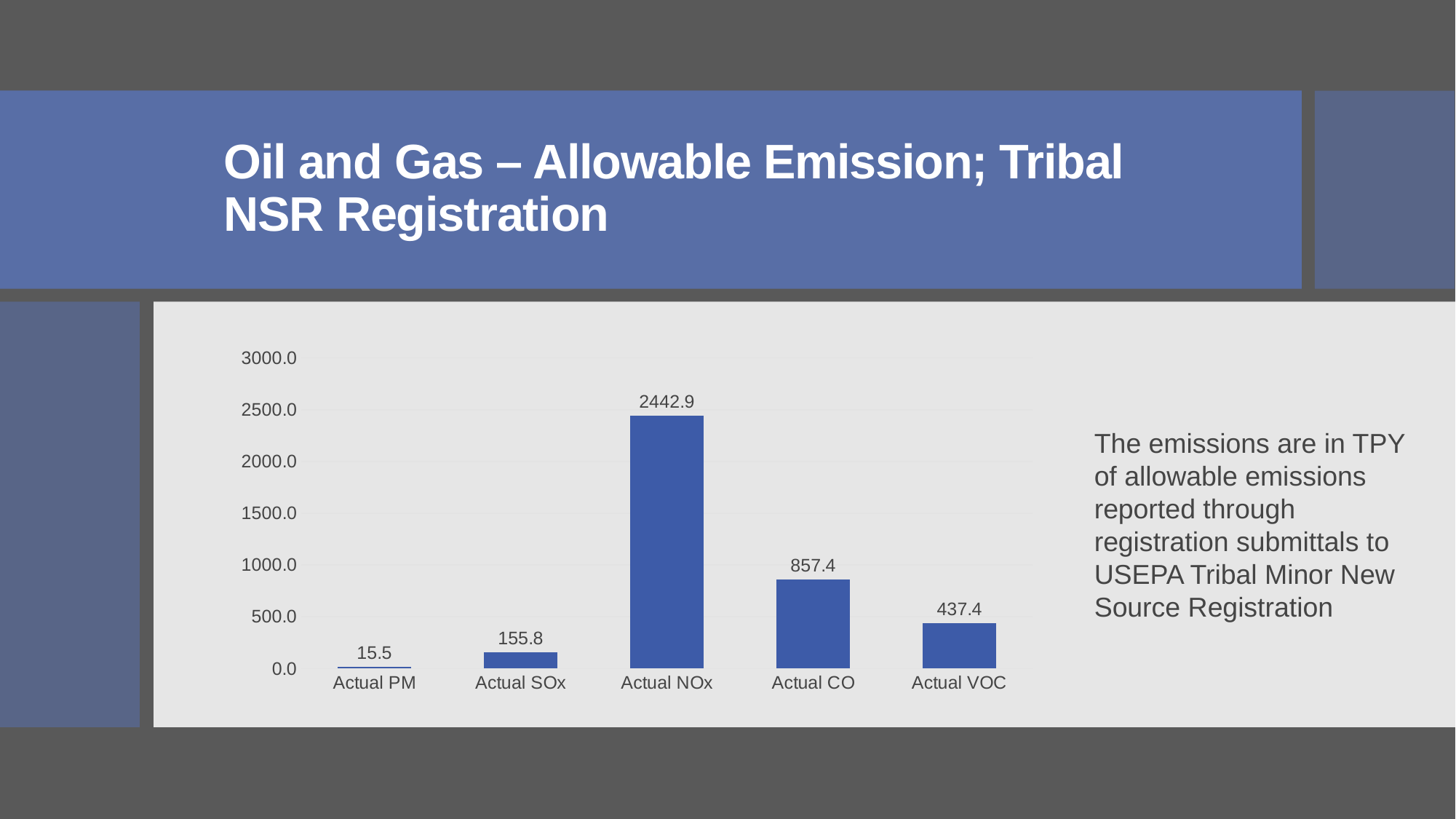
Which is larger, the value for Actual SOx or the value for Actual VOC? Actual VOC Which category has the highest value? Actual NOx What is the difference between the values for Actual NOx and Actual CO? 1585.5 What is the difference between the values for Actual CO and Actual VOC? 420.0 Is the value for Actual NOx greater or less than 2000.0? greater What is the value for Actual VOC? 437.4 What kind of chart is shown on the slide? bar chart What is the value for Actual PM? 15.5 What is the value for Actual NOx? 2442.9 What is the value for Actual CO? 857.4 Which category has the lowest value? Actual PM How many categories are shown on the chart? 5